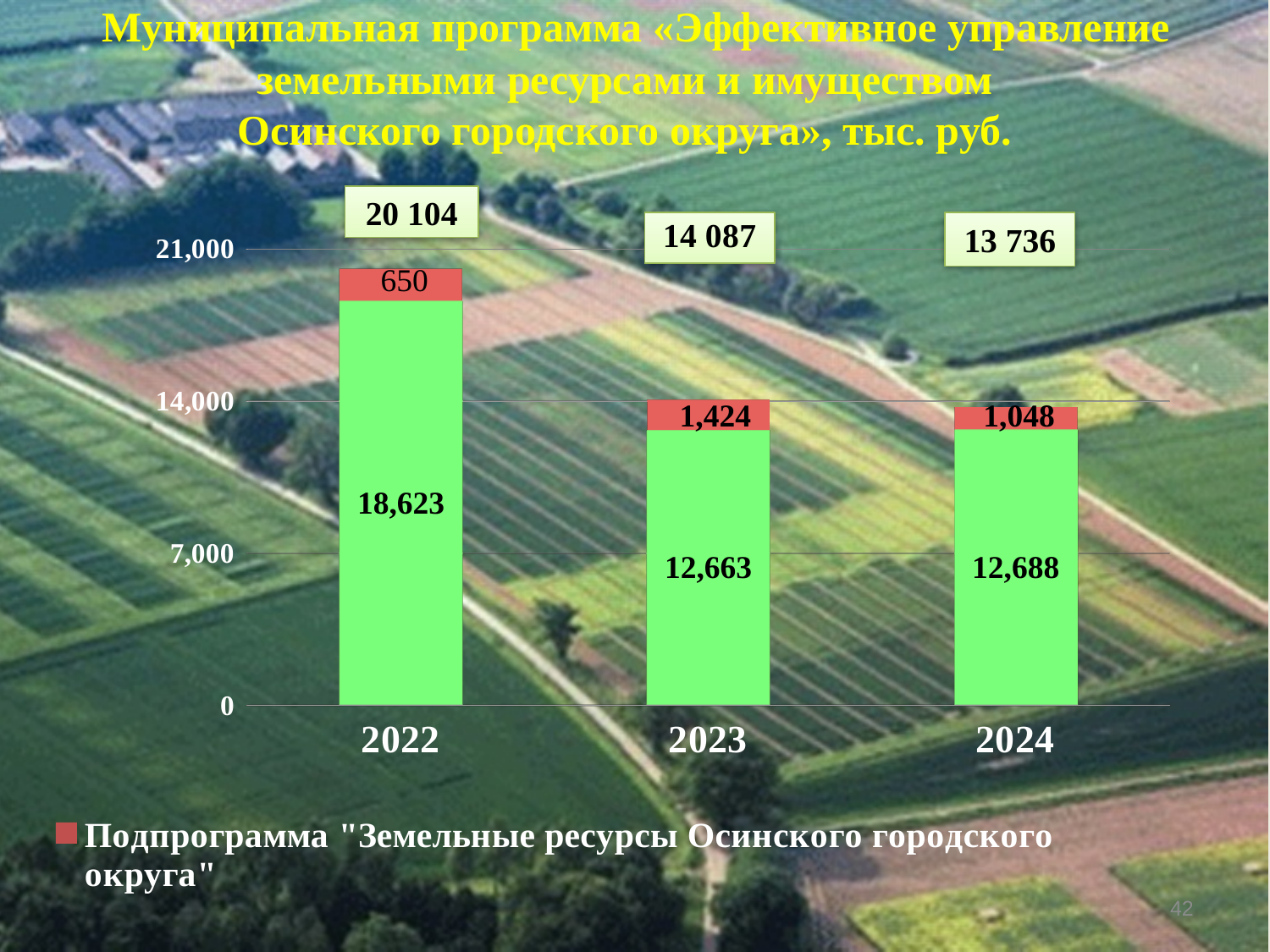
What is the total shown above the 2023 bar? 14 087 What is the value of the green segment for 2022? 18,623 Do the bar totals rise or fall from 2022 to 2024? Fall What is the value of the red segment for 2024? 1,048 What kind of chart is shown on the slide? Stacked bar chart What is the value of the green segment for 2024? 12,688 Which year has the largest green segment? 2022 How many years are shown on the x axis? 3 By how much does the green segment for 2022 exceed the green segment for 2023? 5,960 What is the value of the red segment for 2023? 1,424 Which year has the larger red segment, 2023 or 2024? 2023